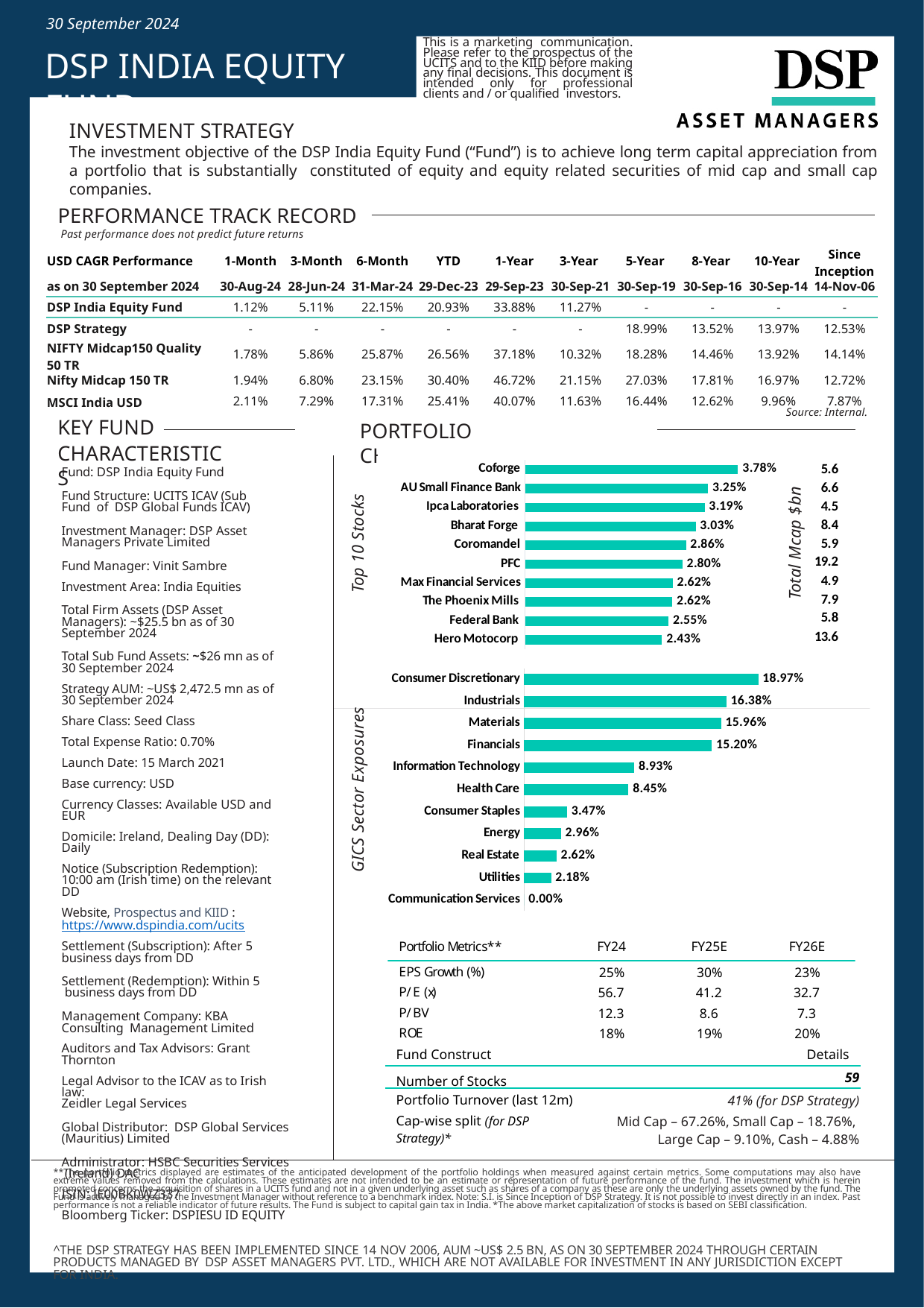
How many sectors are listed in the GICS Sector Exposures chart? 11 In the Top 10 Stocks chart, what is the value for Federal Bank? 2.55% In the Top 10 Stocks chart, what is the difference between the values for Coforge and AU Small Finance Bank? 0.53% In the Top 10 Stocks chart, which stock has the lowest weight? Hero Motocorp In the GICS Sector Exposures chart, which is larger: Industrials or Materials? Industrials In the GICS Sector Exposures chart, what is the difference between Information Technology and Health Care? 0.48% What type of chart is the GICS Sector Exposures chart? Bar chart In the GICS Sector Exposures chart, which sector has the highest exposure? Consumer Discretionary In the GICS Sector Exposures chart, which sector has the lowest exposure? Communication Services How many stocks are shown in the Top 10 Stocks chart? 10 In the GICS Sector Exposures chart, what is the value for Financials? 15.20% In the Top 10 Stocks chart, what is the value for Coforge? 3.78%